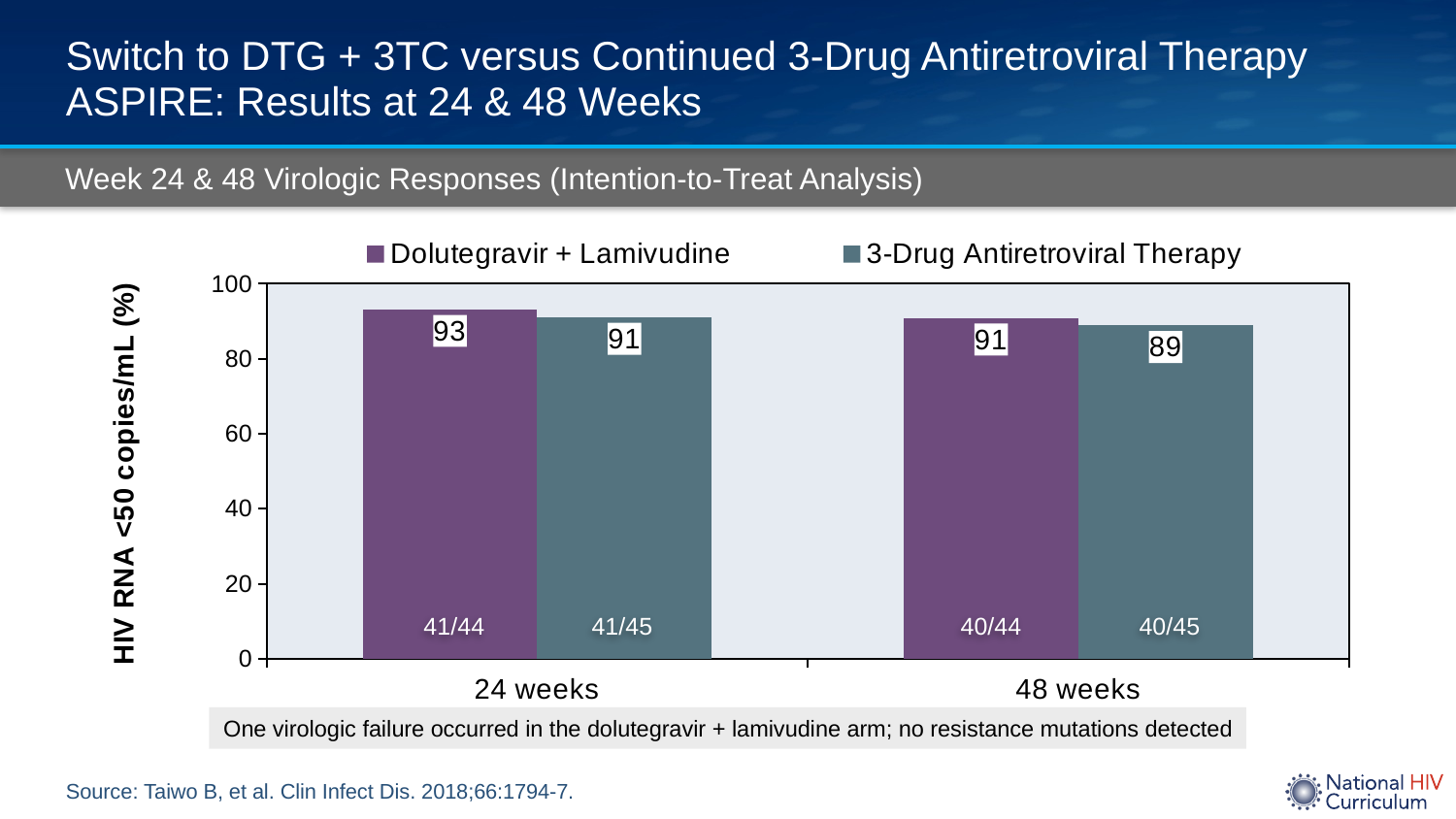
Which bar has the lowest value on the chart? 3-Drug Antiretroviral Therapy at 48 weeks What is the label of the y axis? HIV RNA <50 copies/mL (%) What fraction of participants is shown inside the Dolutegravir + Lamivudine bar at 48 weeks? 40/44 What is the value for Dolutegravir + Lamivudine at 24 weeks? 93 How many series does the legend list? 2 What is the value for 3-Drug Antiretroviral Therapy at 48 weeks? 89 What is the difference between the Dolutegravir + Lamivudine and 3-Drug Antiretroviral Therapy values at 24 weeks? 2 How many time points are shown on the x axis? 2 At 48 weeks, which series has the larger value, Dolutegravir + Lamivudine or 3-Drug Antiretroviral Therapy? Dolutegravir + Lamivudine Which bar has the highest value on the chart? Dolutegravir + Lamivudine at 24 weeks What kind of chart is shown on the slide? Bar chart What is the value for 3-Drug Antiretroviral Therapy at 24 weeks? 91